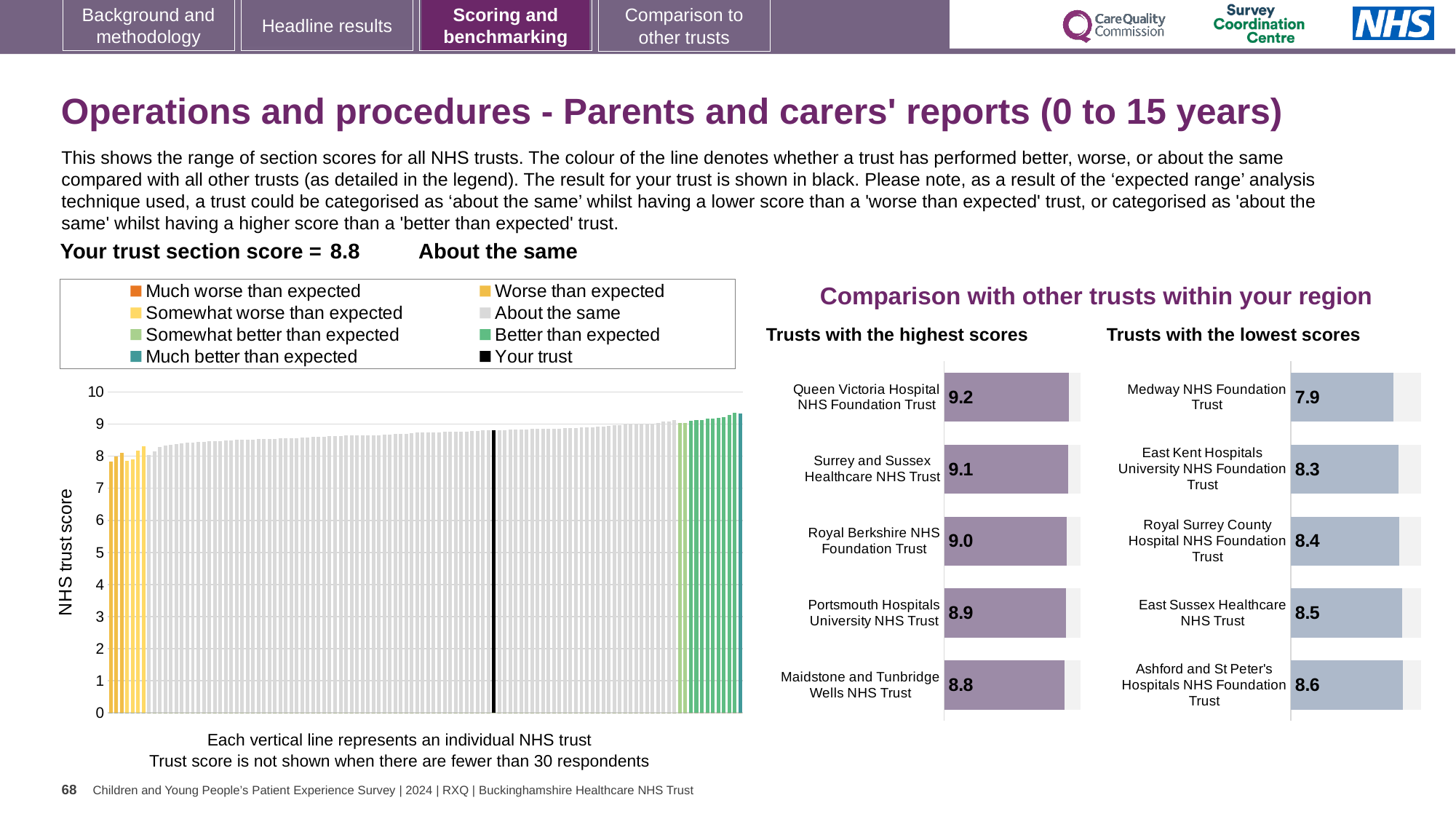
In the 'Trusts with the highest scores' chart, how many trusts are shown? 5 In the 'Trusts with the lowest scores' chart, which has the larger score: East Kent Hospitals University NHS Foundation Trust or Ashford and St Peter's Hospitals NHS Foundation Trust? Ashford and St Peter's Hospitals NHS Foundation Trust In the 'Trusts with the lowest scores' chart, which trust has the lowest score? Medway NHS Foundation Trust In the 'Trusts with the highest scores' chart, what is the score for Queen Victoria Hospital NHS Foundation Trust? 9.2 In the large chart on the left, do the trust scores rise or fall from left to right? rise What kind of chart is the large chart on the left showing NHS trust scores? bar chart In the 'Trusts with the lowest scores' chart, what is the score for Medway NHS Foundation Trust? 7.9 In the large chart on the left, how many entries does the legend list? 8 In the large chart on the left, what is the section score for your trust (the black line)? 8.8 In the large chart on the left, is the value for your trust (the black line) greater or less than 8? greater In the 'Trusts with the highest scores' chart, which trust has the highest score? Queen Victoria Hospital NHS Foundation Trust In the 'Trusts with the highest scores' chart, what is the difference between the scores of Queen Victoria Hospital NHS Foundation Trust and Maidstone and Tunbridge Wells NHS Trust? 0.4